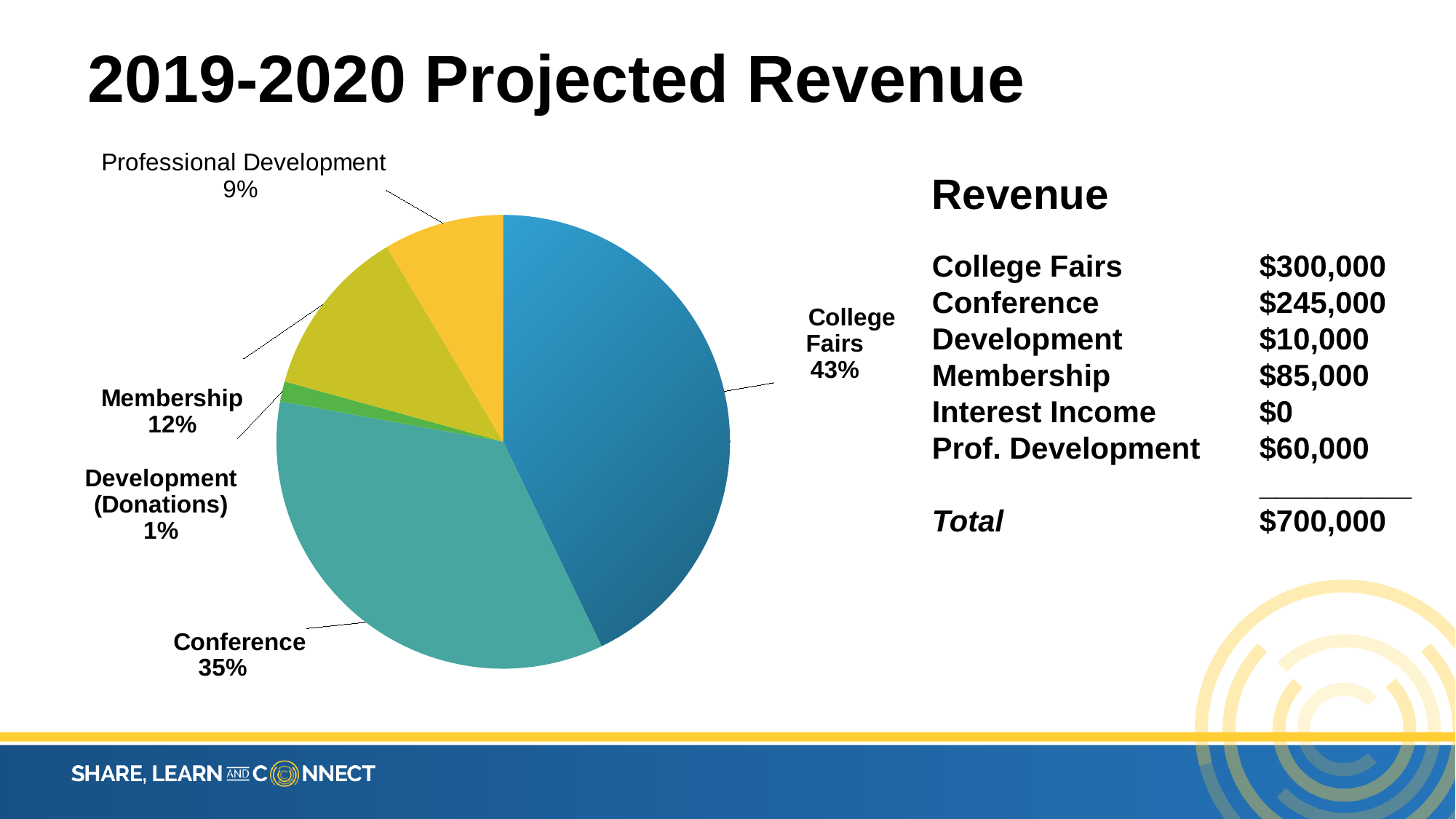
What share of the pie does Membership represent? 12% Which slice is larger, Membership or Professional Development? Membership What share of the pie does Professional Development represent? 9% What share of the pie does College Fairs represent? 43% What type of chart is shown on the slide? pie chart Which slice of the pie is the largest? College Fairs Which slice of the pie is the smallest? Development (Donations) What is the difference in percentage points between the College Fairs slice and the Conference slice? 8% How many slices are labelled on the pie chart? 5 What colour is the College Fairs slice? blue